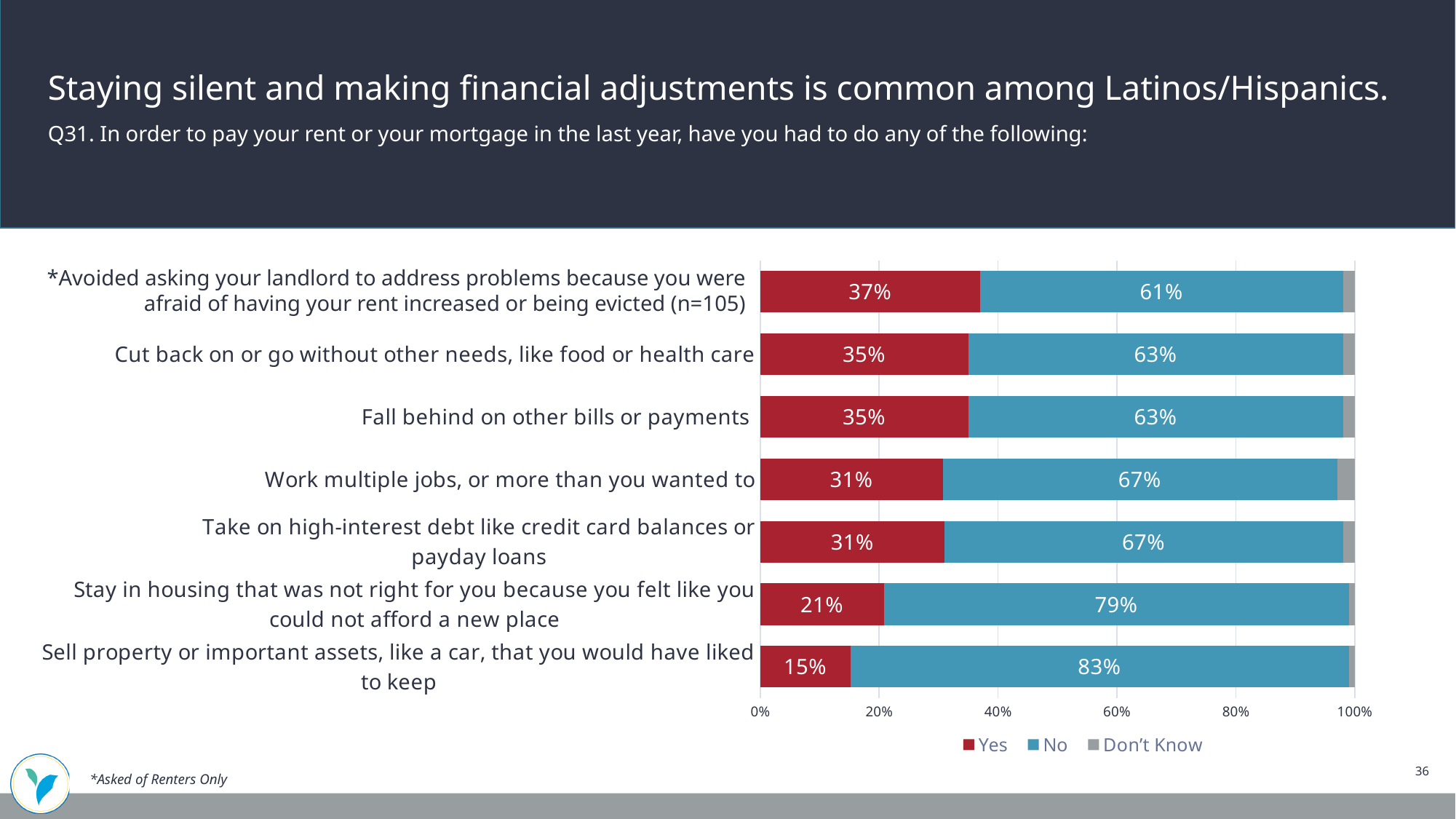
What percentage answered Yes to "Sell property or important assets, like a car, that you would have liked to keep"? 15% What kind of chart is shown on the slide? Stacked bar chart Which has a larger Yes percentage: "Cut back on or go without other needs, like food or health care" or "Work multiple jobs, or more than you wanted to"? Cut back on or go without other needs, like food or health care What is the Yes value for "Avoided asking your landlord to address problems because you were afraid of having your rent increased or being evicted"? 37% How many series does the legend list? 3 Which category has the lowest Yes percentage? Sell property or important assets, like a car, that you would have liked to keep What percentage answered No to "Stay in housing that was not right for you because you felt like you could not afford a new place"? 79% What is the difference in percentage points between the Yes value for "Avoided asking your landlord to address problems" and the Yes value for "Sell property or important assets"? 22 percentage points Which colour represents the Yes responses in the chart? Red Which category has the highest Yes percentage? Avoided asking your landlord to address problems because you were afraid of having your rent increased or being evicted Is the Don't Know value for "Avoided asking your landlord to address problems" greater or less than 20%? less How many categories are shown in the chart? 7